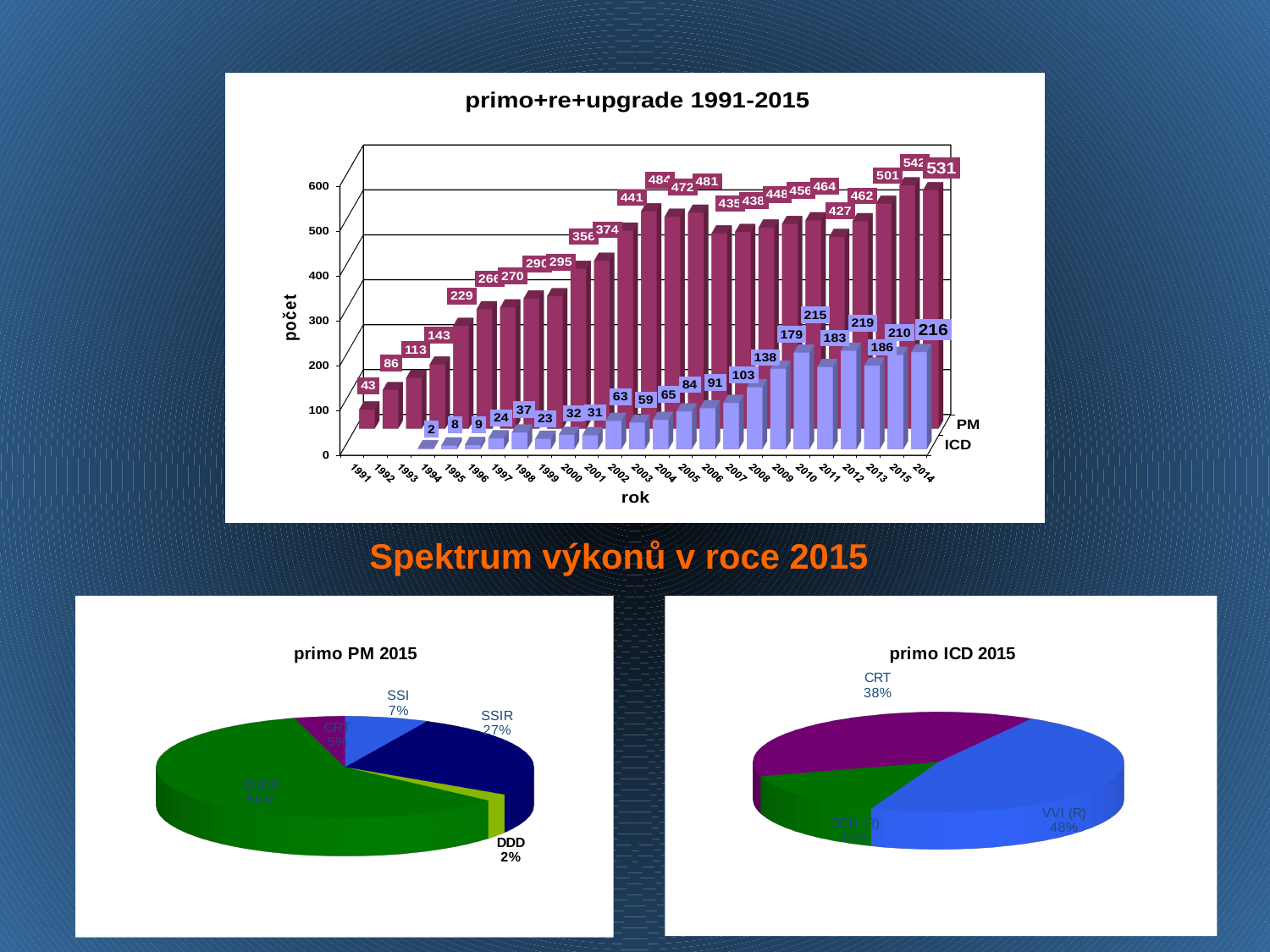
In the chart titled 'primo+re+upgrade 1991-2015', what is the ICD value for 2008? 138 In the pie chart titled 'primo PM 2015', what share does SSIR have? 27% In the chart titled 'primo+re+upgrade 1991-2015', which year has the larger PM value, 2005 or 2006? 2005 In the chart titled 'primo+re+upgrade 1991-2015', which year has the lowest ICD value? 1994 In the chart titled 'primo+re+upgrade 1991-2015', what is the difference between the PM value and the ICD value for 2013? 315 In the chart titled 'primo+re+upgrade 1991-2015', do the ICD values generally rise or fall from 1994 to 2010? rise In the chart titled 'primo+re+upgrade 1991-2015', how many series does the legend list? 2 In the chart titled 'primo+re+upgrade 1991-2015', what is the PM value for 1991? 43 In the chart titled 'primo+re+upgrade 1991-2015', what kind of chart is it? bar chart In the chart titled 'primo+re+upgrade 1991-2015', what is the PM value for 2002? 441 In the pie chart titled 'primo ICD 2015', what share does CRT have? 38% In the pie chart titled 'primo ICD 2015', which category has the largest share? VVI (R)